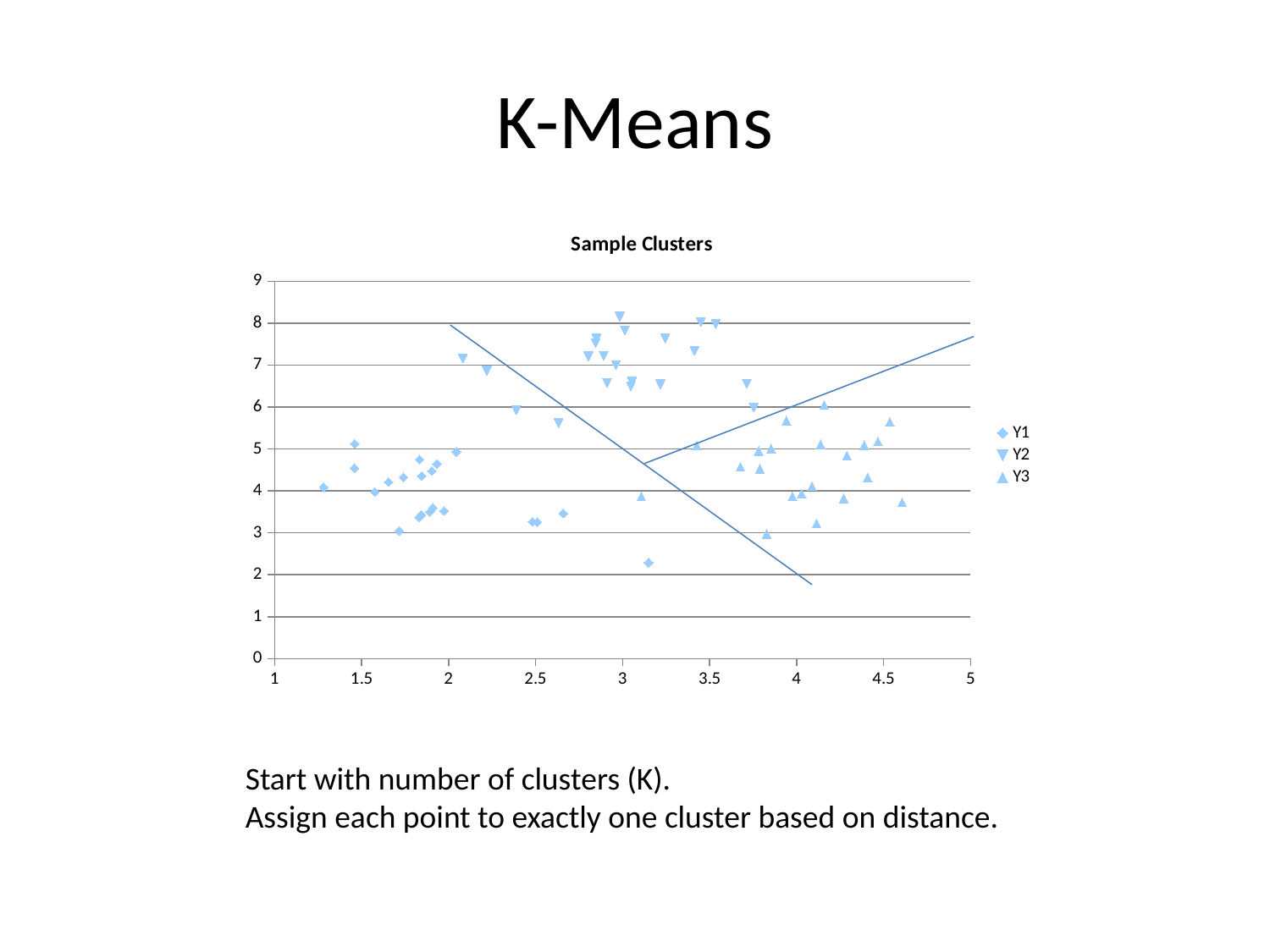
Is the highest Y2 point greater or less than 7 on the y axis? greater What is the title of the chart? Sample Clusters How many series does the legend list? 3 Which series has points located furthest to the left on the x axis? Y1 Which series contains the points with the highest y values? Y2 Is the lowest Y1 point greater or less than 3 on the y axis? less Which series contains the point with the lowest y value? Y1 Which series has points located furthest to the right on the x axis? Y3 What kind of chart is shown on the slide? scatter chart What are the series names listed in the legend? Y1, Y2, Y3 Are the Y2 points generally higher or lower on the y axis than the Y3 points? higher